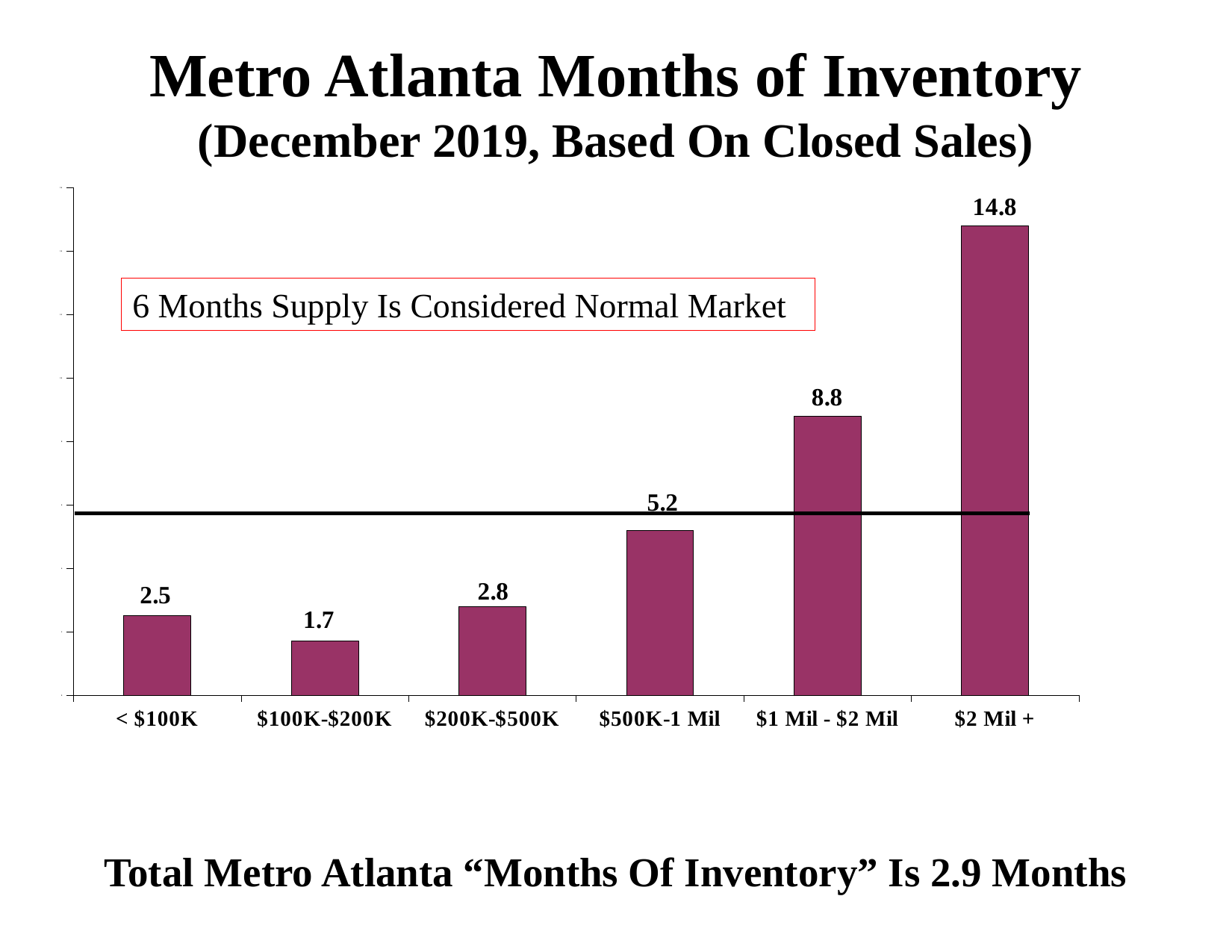
What is the difference in months of inventory between the $200K-$500K and < $100K price ranges? 0.3 What is the months of inventory for the $2 Mil + price range? 14.8 What is the difference in months of inventory between the $2 Mil + and $1 Mil - $2 Mil price ranges? 6.0 According to the text box on the chart, how many months of supply is considered a normal market? 6 months Which price range has the highest months of inventory? $2 Mil + What kind of chart is shown on the slide? Bar chart Which price range has the lowest months of inventory? $100K-$200K Which has a higher months of inventory, < $100K or $200K-$500K? $200K-$500K Do the months of inventory values generally rise or fall as the price range increases from $100K-$200K to $2 Mil +? Rise How many price ranges are shown on the chart? 6 What is the months of inventory for the $500K-1 Mil price range? 5.2 What is the months of inventory for the $100K-$200K price range? 1.7